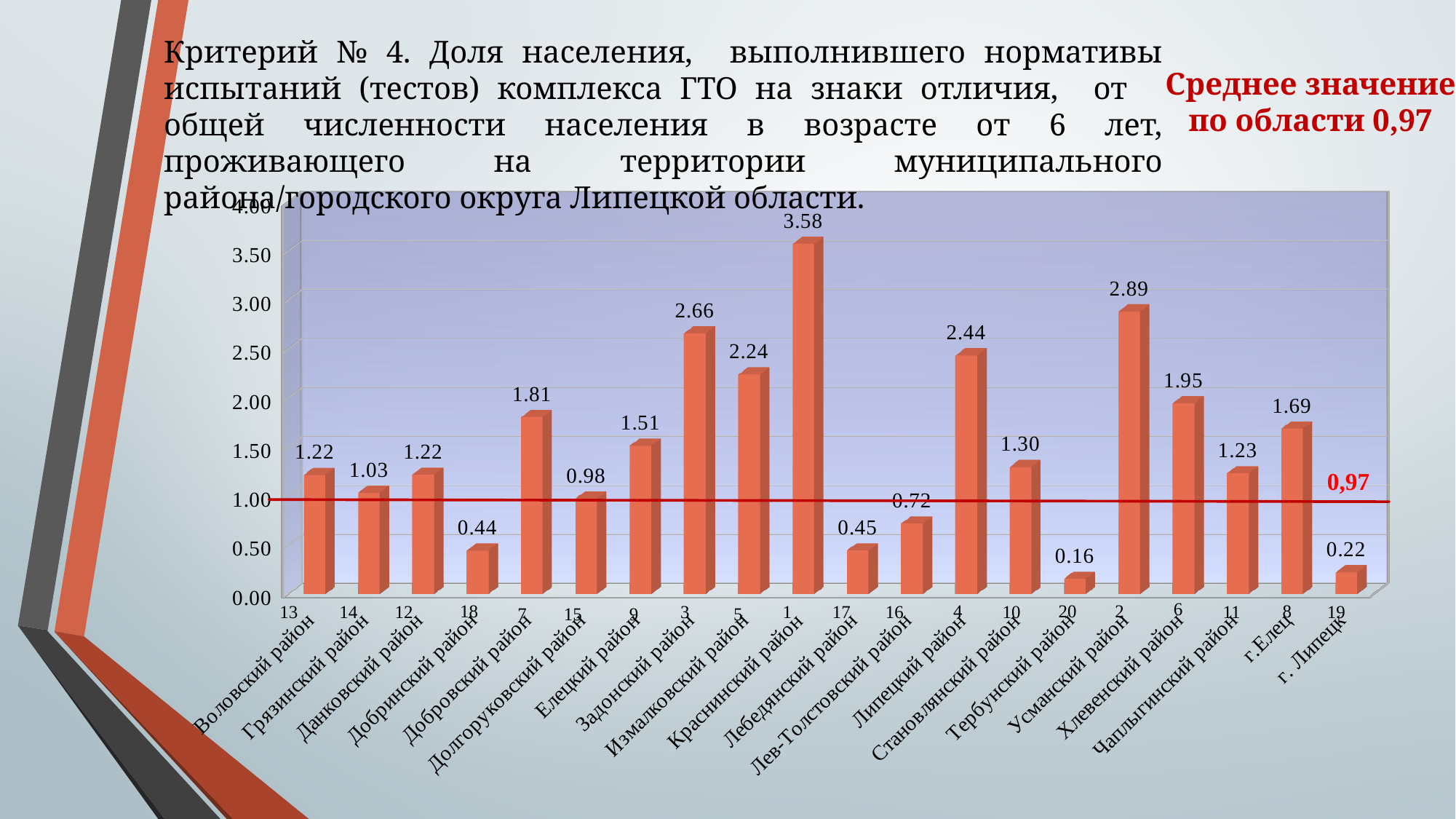
What is the difference between the values for Задонский район and Липецкий район? 0.22 What value does the red horizontal line on the chart mark? 0,97 What is the value shown for г. Липецк? 0.22 Which has a larger value, Добровский район or Хлевенский район? Хлевенский район What is the value shown for Усманский район? 2.89 Which district has the lowest value on the chart? Тербунский район What kind of chart is shown on the slide? bar chart Which district has the highest value on the chart? Краснинский район Is the value for Измалковский район greater or less than 2.00? greater How many districts (categories) are plotted on the chart? 20 What is the value shown for Краснинский район? 3.58 What is the value shown for Лев-Толстовский район? 0.72